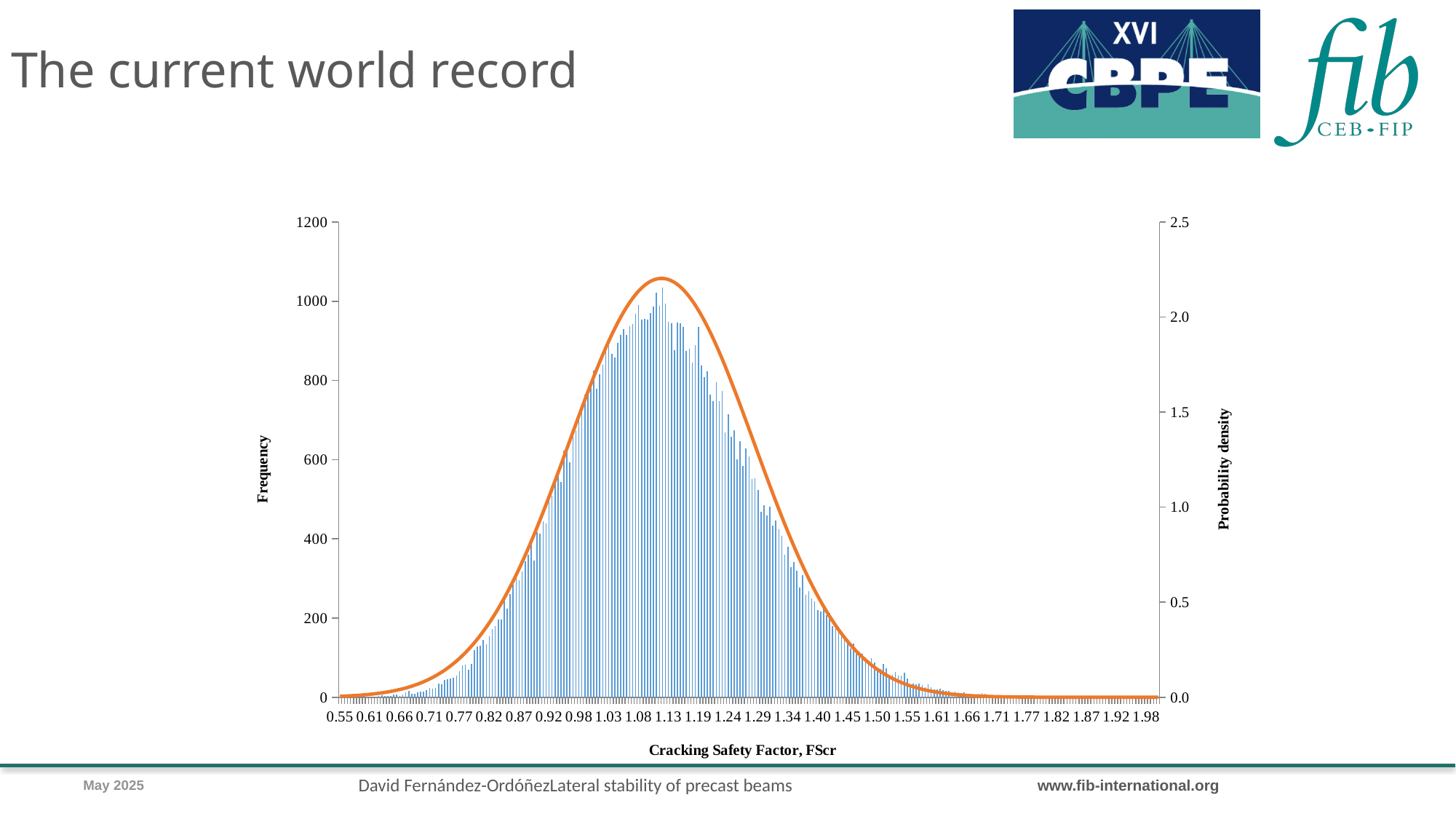
Is the frequency at 1.03 greater or less than 600? greater Which has the higher frequency, 0.87 or 1.50? 0.87 What is the title of the x axis of the chart? Cracking Safety Factor, FScr Is the frequency at 1.13 greater or less than 800? greater Which has the higher frequency, 1.03 or 1.34? 1.03 Is the frequency at 0.55 greater or less than 200? less What is the title of the left y axis of the chart? Frequency Do the frequencies rise or fall as the cracking safety factor increases from 0.55 to 1.13? rise What kind of chart is shown on the slide? combination bar and line chart Around which x-axis label do the bars reach their highest values? 1.13